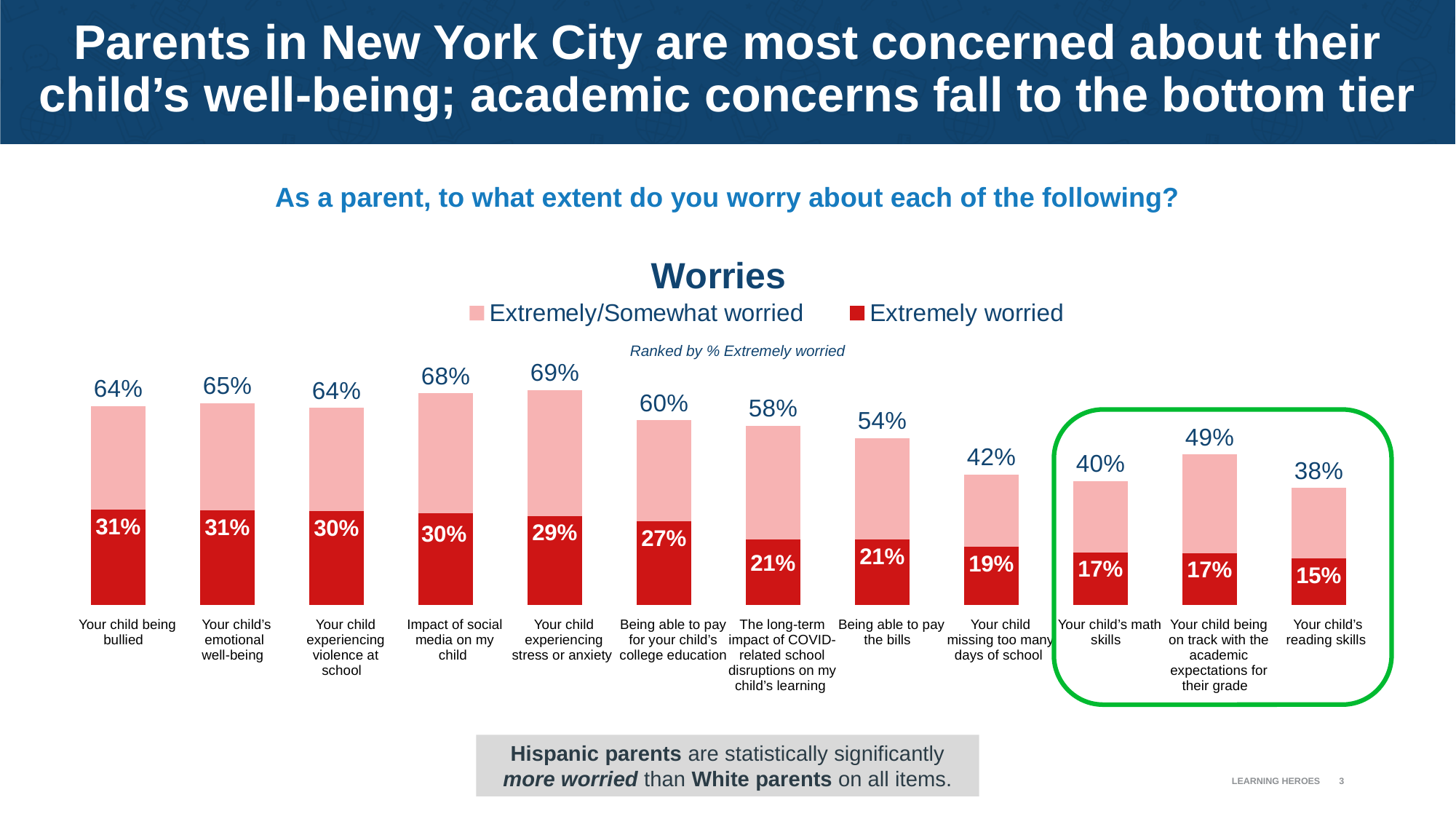
How many series does the legend list? 2 What is the Extremely/Somewhat worried value for 'Your child experiencing stress or anxiety'? 69% What is the chart's title? Worries What is the Extremely worried value for 'Your child's reading skills'? 15% Which category has the highest Extremely/Somewhat worried value? Your child experiencing stress or anxiety Which category has the lowest Extremely worried value? Your child's reading skills Which has a larger Extremely worried value: 'Being able to pay for your child's college education' or 'Your child missing too many days of school'? Being able to pay for your child's college education What is the difference between the Extremely/Somewhat worried values for 'Your child being bullied' and 'Your child's math skills'? 24% Which series is shown in dark red in the legend? Extremely worried What percentage of parents are Extremely worried about their child being bullied? 31% What type of chart is shown on the slide? bar chart How many categories are shown on the x axis of the chart? 12